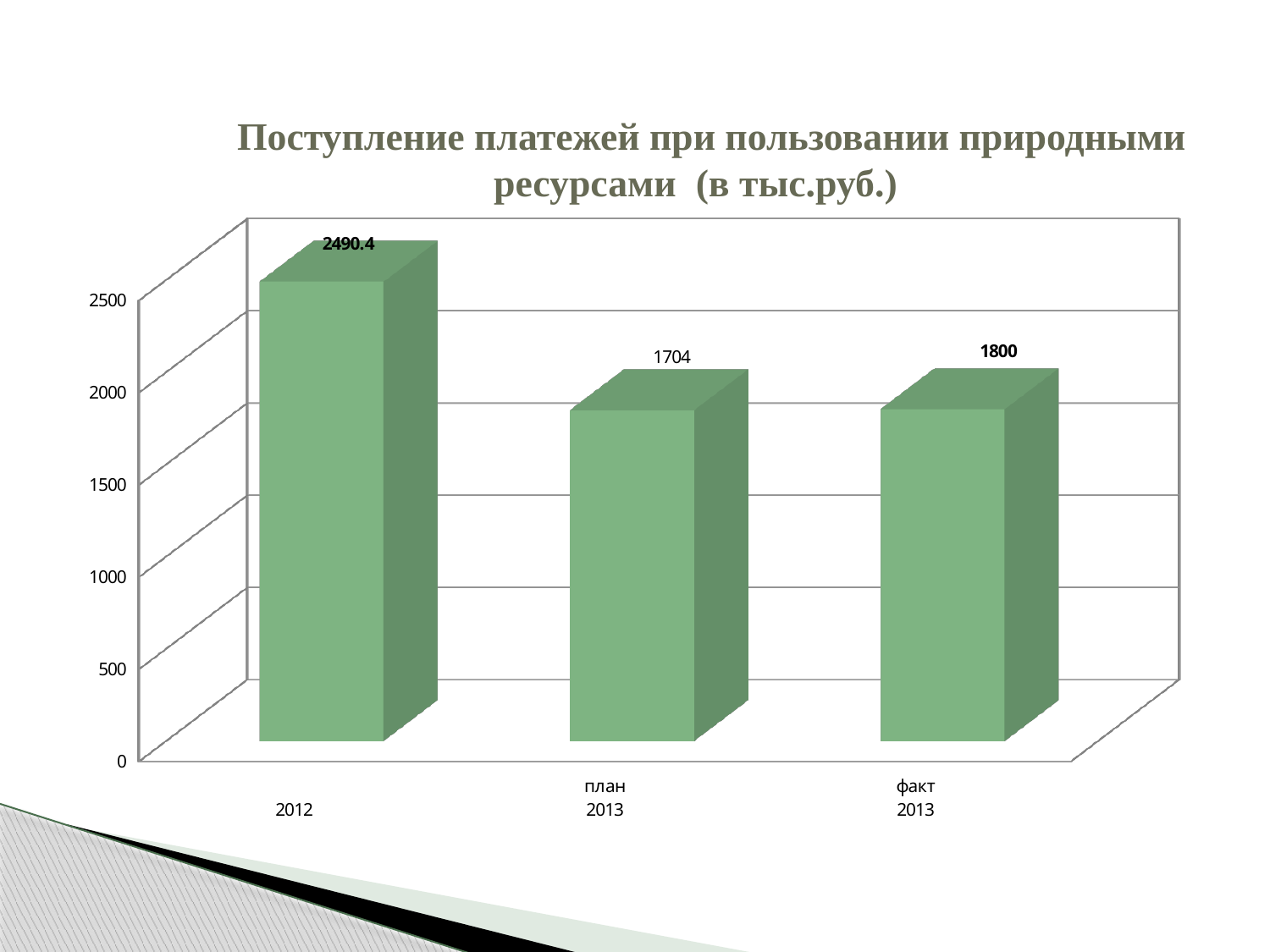
Which category has the highest value? 2012 Is the value for 2012 greater or less than 2000? greater What is the difference between the values for 2012 and факт 2013? 690.4 Which is larger, the value for план 2013 or факт 2013? факт 2013 What unit is given in the chart title? тыс.руб. What is the difference between the values for факт 2013 and план 2013? 96 What is the value for план 2013? 1704 What kind of chart is shown on the slide? bar chart Which category has the lowest value? план 2013 What is the value for факт 2013? 1800 How many categories are shown on the chart? 3 What is the value for 2012? 2490.4